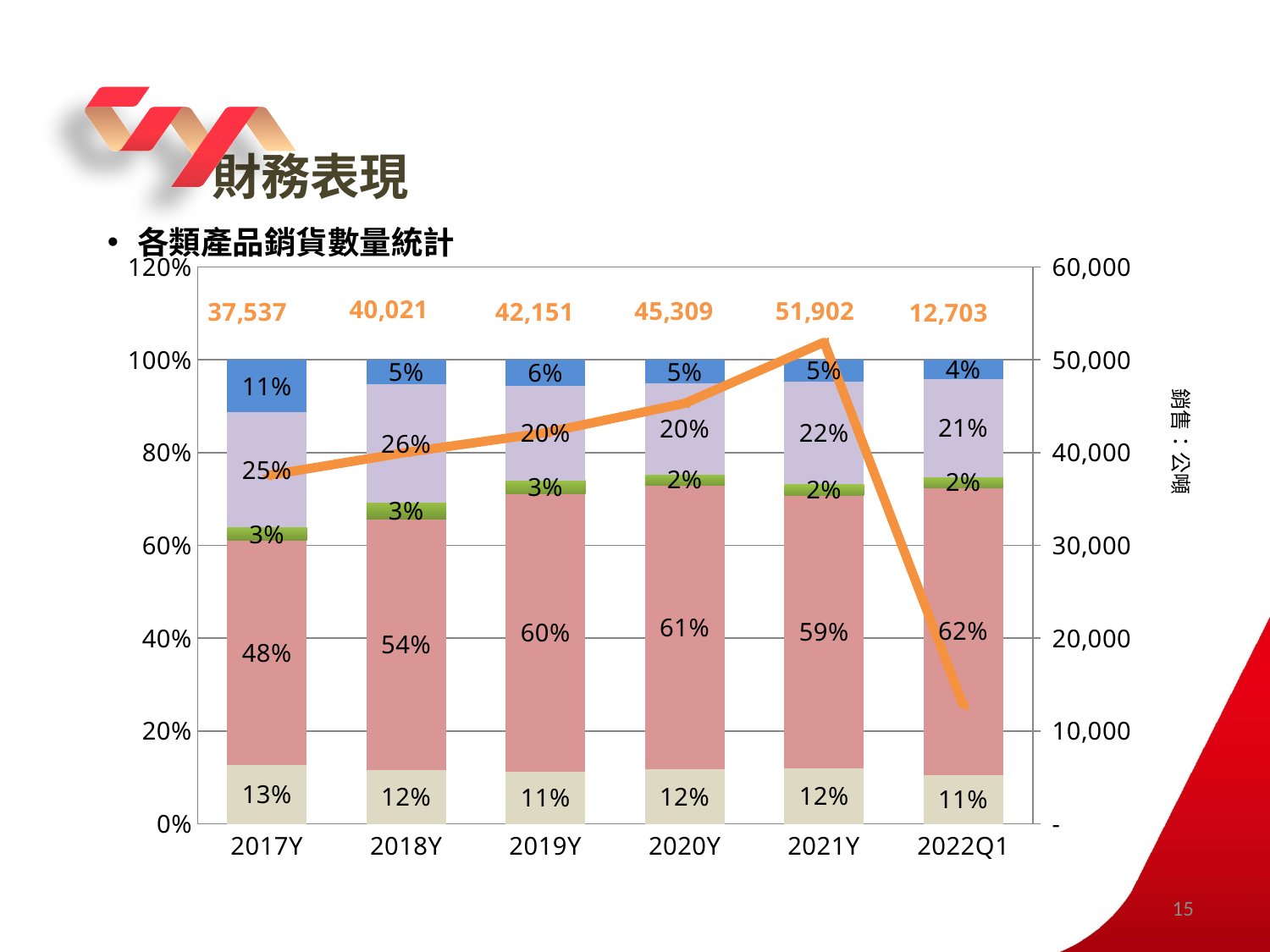
What is the difference between the total sales volume for 2021Y and 2020Y? 6,593 What percentage does the largest (pink) segment represent for 2022Q1? 62% Which period has the lowest total sales volume shown on the orange line? 2022Q1 Which is larger, the total sales volume for 2018Y or 2019Y? 2019Y Does the total sales volume on the orange line rise or fall from 2017Y to 2021Y? Rise What is the total sales volume (orange line label) for 2017Y? 37,537 How many periods are shown on the x axis? 6 What kind of chart is this? Stacked bar chart with a line What percentage does the bottom (beige) segment represent for 2019Y? 11% What is the total sales volume (orange line label) for 2021Y? 51,902 Which period has the highest total sales volume shown on the orange line? 2021Y What percentage does the top (blue) segment represent for 2017Y? 11%